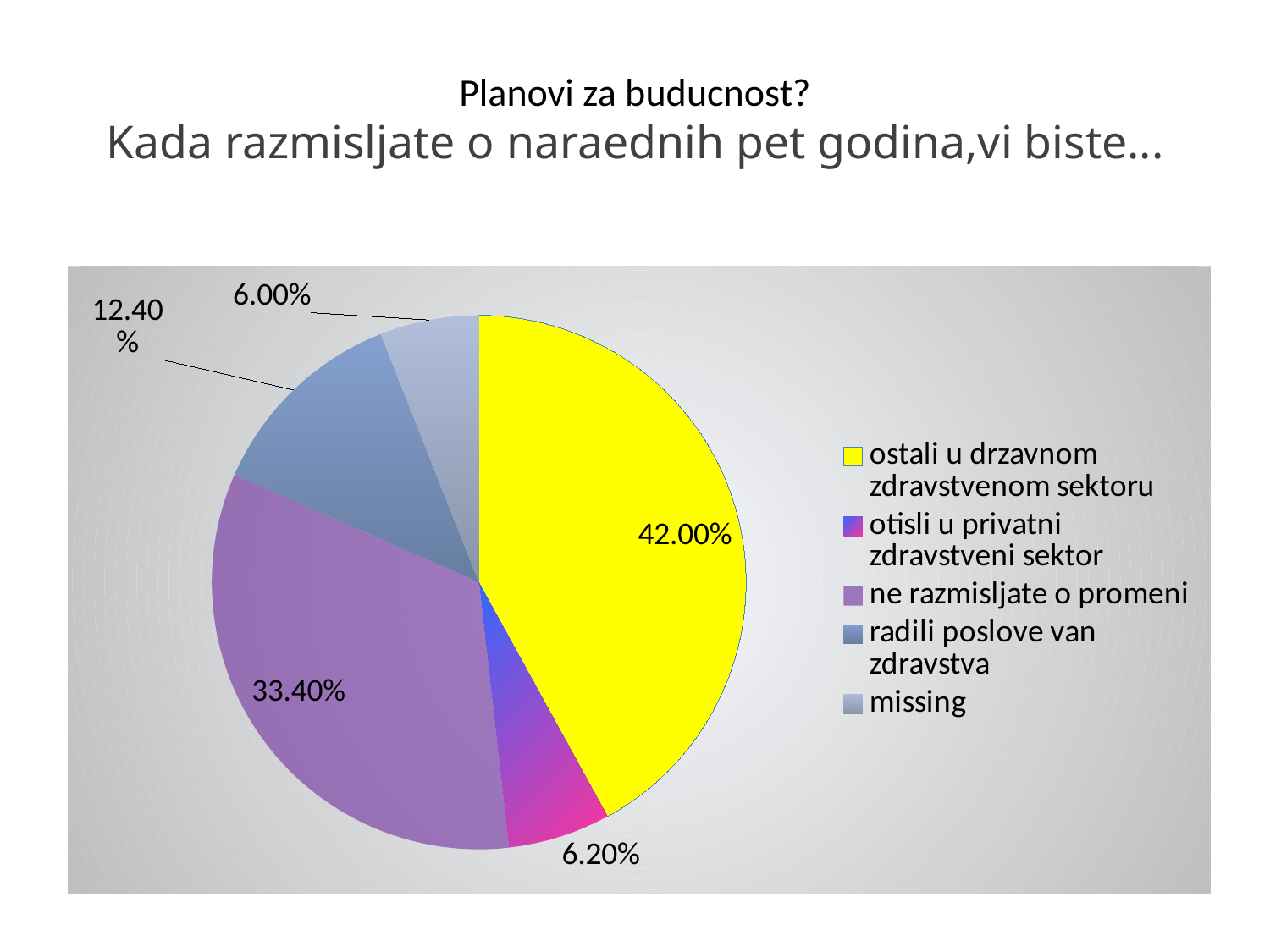
What percentage is shown for "missing"? 6.00% Which category has the largest slice of the pie? ostali u drzavnom zdravstvenom sektoru What kind of chart is shown on the slide? pie chart What is the difference between the percentages for "ostali u drzavnom zdravstvenom sektoru" and "ne razmisljate o promeni"? 8.60% Which category has the smallest slice of the pie? missing What percentage is shown for "ne razmisljate o promeni"? 33.40% What percentage is shown for "ostali u drzavnom zdravstvenom sektoru"? 42.00% What percentage is shown for "radili poslove van zdravstva"? 12.40% What percentage is shown for "otisli u privatni zdravstveni sektor"? 6.20% Which is larger: the slice for "radili poslove van zdravstva" or the slice for "otisli u privatni zdravstveni sektor"? radili poslove van zdravstva What colour is the slice for "ostali u drzavnom zdravstvenom sektoru"? yellow How many categories does the legend list? 5